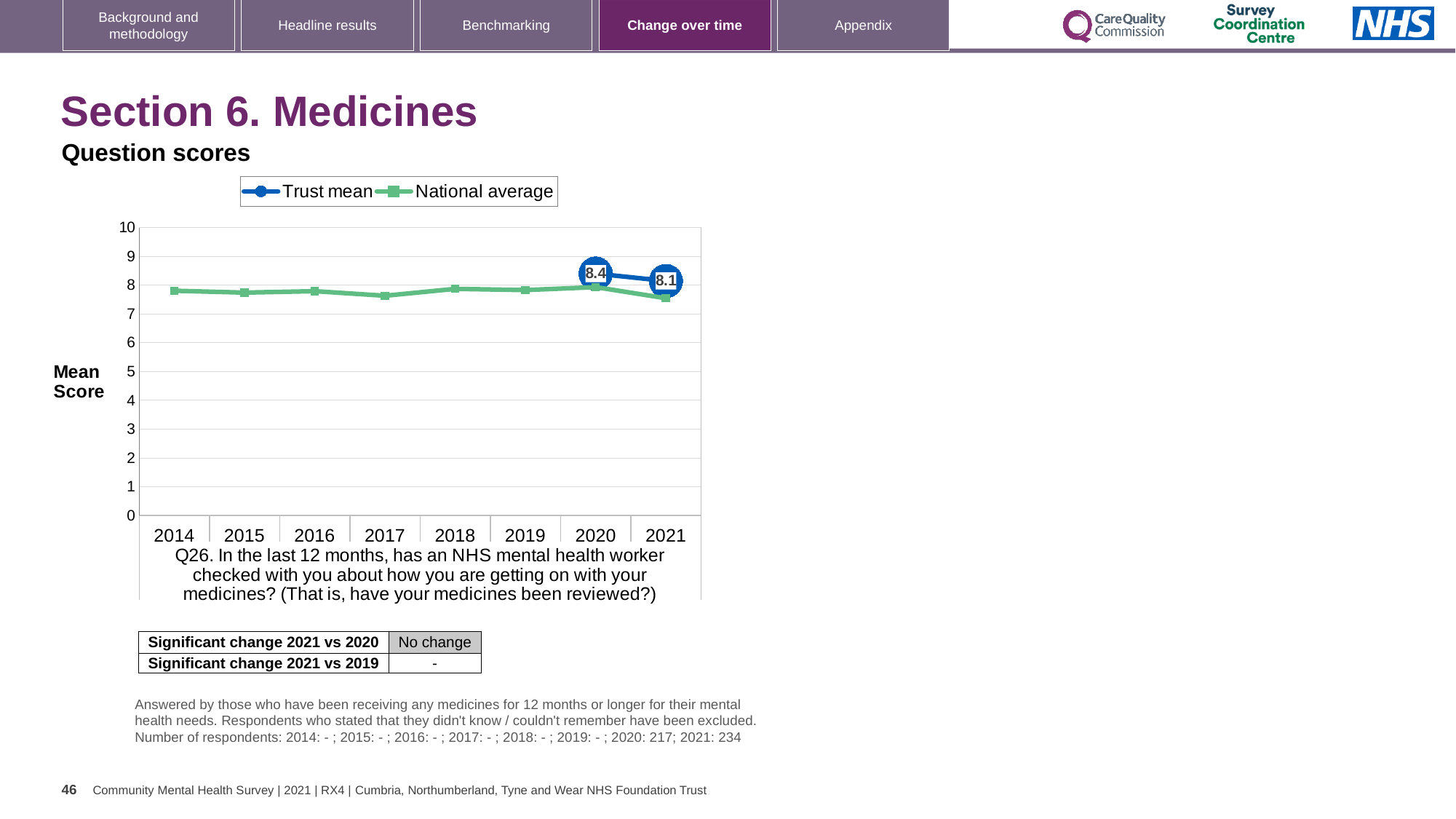
Which year has the higher Trust mean score, 2020 or 2021? 2020 Did the Trust mean score rise or fall from 2020 to 2021? fall Is the National average value for 2021 greater or less than 8? less What is the Trust mean score for 2021? 8.1 Is the National average value for 2014 greater or less than 7? greater By how much did the Trust mean score change between 2020 and 2021? 0.3 What is the Trust mean score for 2020? 8.4 In 2021, which series has the higher value, Trust mean or National average? Trust mean What is the label on the y axis of the chart? Mean Score How many years are shown on the x axis of the chart? 8 What kind of chart is shown on the slide? line chart How many series does the chart legend list? 2